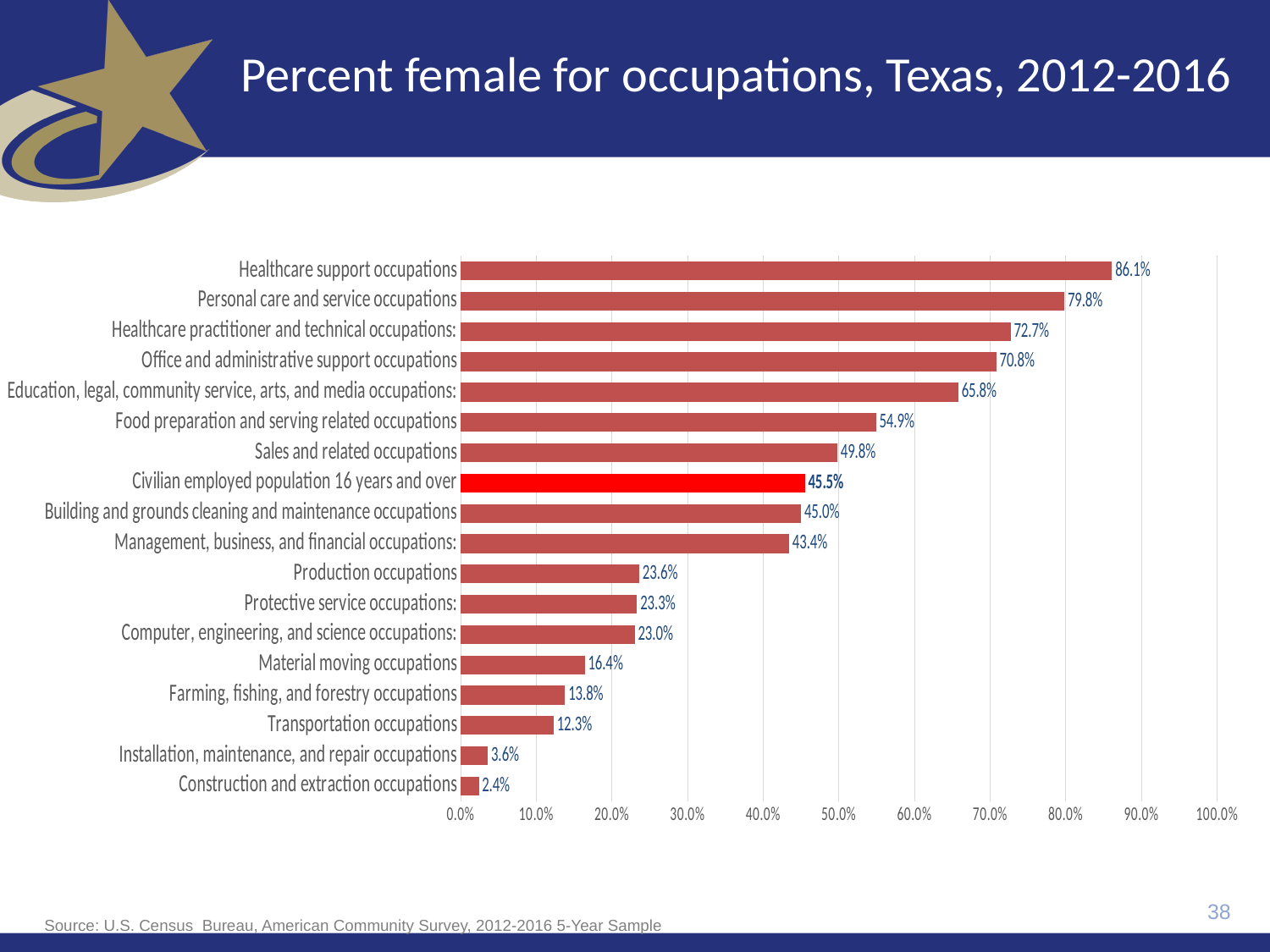
How many categories are shown on the chart? 18 What is the percent female for the Civilian employed population 16 years and over? 45.5% Which occupation category has the highest percent female? Healthcare support occupations What is the difference in percent female between Healthcare support occupations and Personal care and service occupations? 6.3% What is the percent female for Healthcare support occupations? 86.1% What is the difference in percent female between Transportation occupations and Installation, maintenance, and repair occupations? 8.7% Which occupation category has the lowest percent female? Construction and extraction occupations Is the value for Food preparation and serving related occupations greater or less than 50.0%? greater Which bar is highlighted in a different colour (bright red) from the others? Civilian employed population 16 years and over What kind of chart is shown on the slide? Bar chart What is the percent female for Sales and related occupations? 49.8% Which has a higher percent female, Production occupations or Material moving occupations? Production occupations